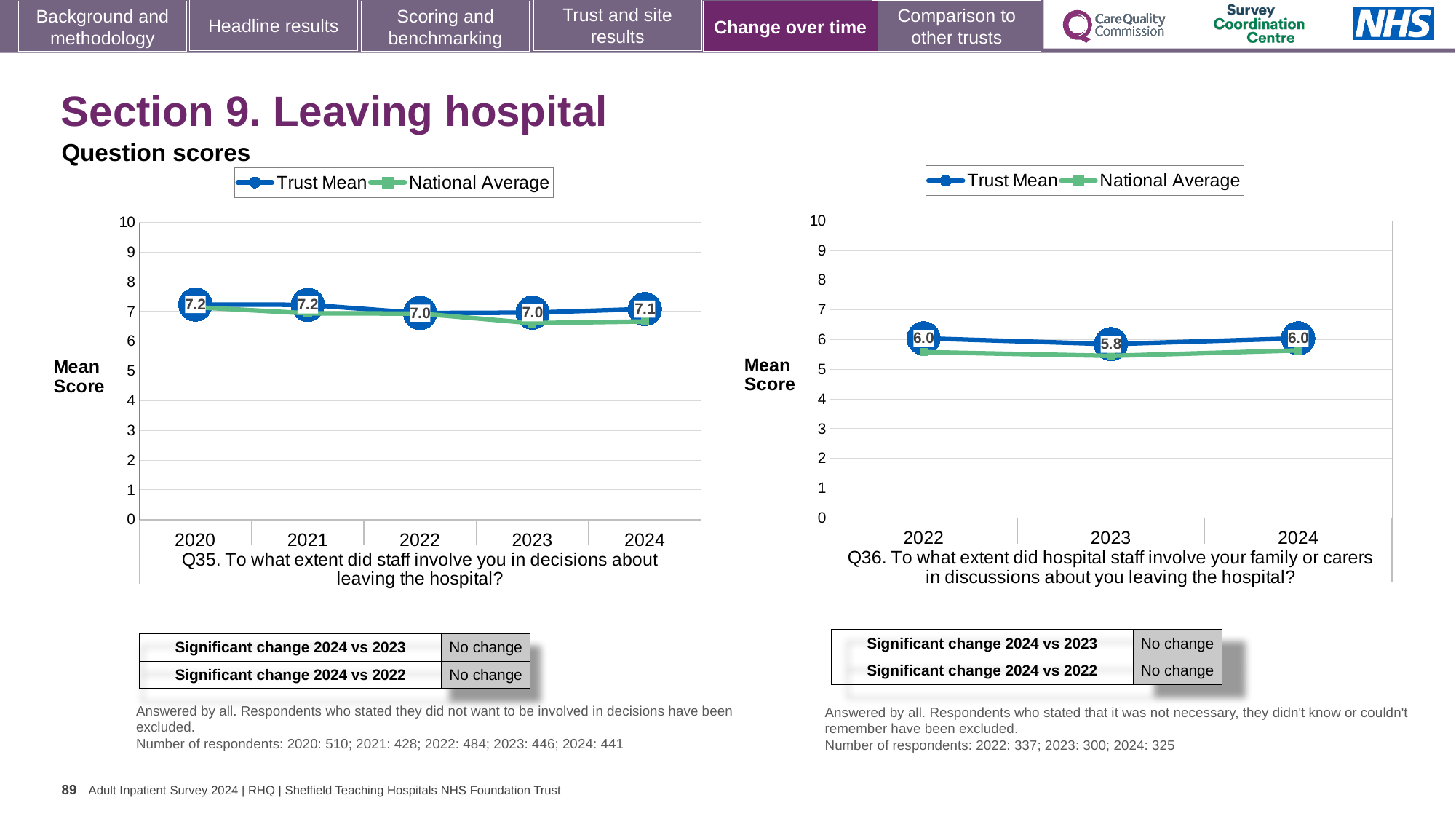
On the Q35 chart (left), is the National Average for 2023 greater or less than 7? less On the Q35 chart (left), what is the difference between the Trust Mean score in 2020 and in 2022? 0.2 On the Q35 chart (left), what is the Trust Mean score for 2020? 7.2 On the Q35 chart (left), what is the label of the y axis? Mean Score What kind of chart is the Q35 chart (left)? Line chart On the Q36 chart (right), what is the Trust Mean score for 2023? 5.8 On the Q36 chart (right), which year has the lowest Trust Mean score? 2023 On the Q35 chart (left), what is the Trust Mean score for 2024? 7.1 How many years are plotted on the Q35 chart (left)? 5 How many series does the legend of the Q36 chart (right) list? 2 On the Q36 chart (right), is the Trust Mean score for 2022 greater or less than the score for 2023? greater On the Q36 chart (right), what is the Trust Mean score for 2024? 6.0